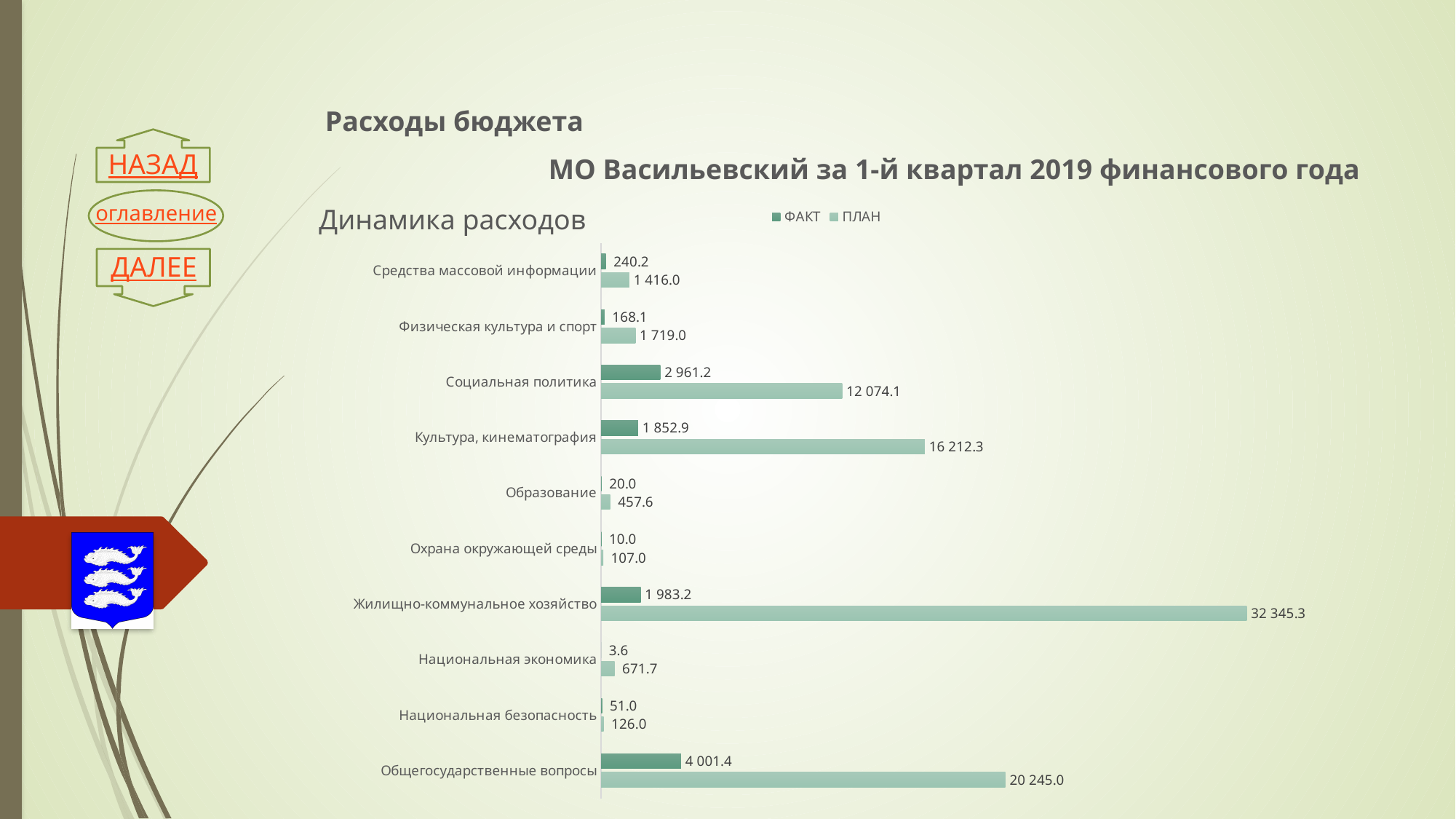
What is the ПЛАН value for Жилищно-коммунальное хозяйство? 32 345.3 How many categories are shown in the chart? 10 How many series does the legend list? 2 Which is larger: the ФАКТ value for Социальная политика or the ФАКТ value for Жилищно-коммунальное хозяйство? Социальная политика Which category has the lowest ФАКТ value? Национальная экономика Which category has the highest ПЛАН value? Жилищно-коммунальное хозяйство What is the ПЛАН value for Образование? 457.6 Which category has the lowest ПЛАН value? Охрана окружающей среды What is the difference between the ПЛАН and ФАКТ values for Культура, кинематография? 14 359.4 What type of chart is shown on the slide? Bar chart Which category has the highest ФАКТ value? Общегосударственные вопросы What is the ФАКТ value for Общегосударственные вопросы? 4 001.4